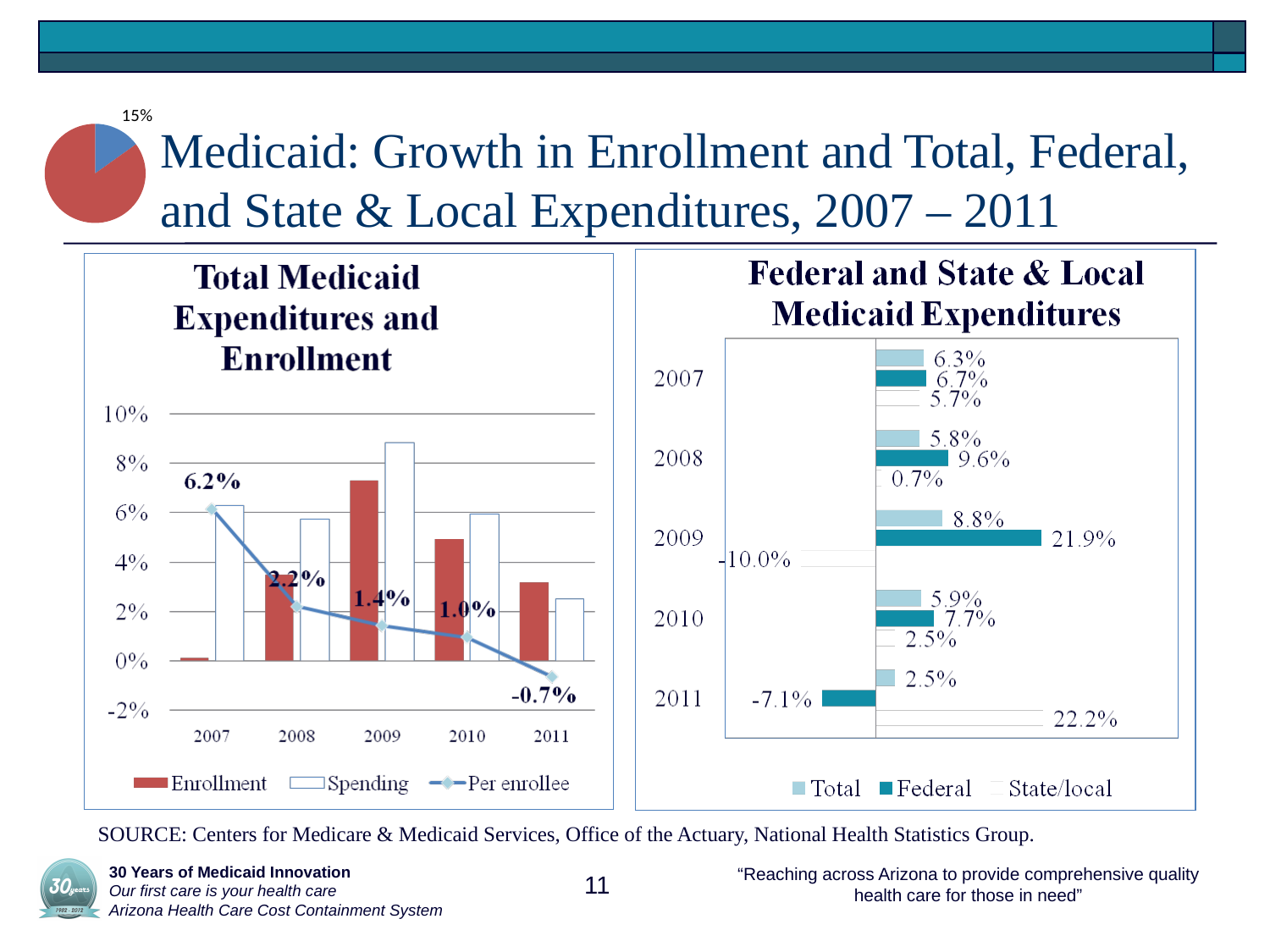
What kind of chart is the 'Federal and State & Local Medicaid Expenditures' chart? bar chart In the 'Total Medicaid Expenditures and Enrollment' chart, is the Enrollment value for 2009 greater or less than 6%? greater How many years are shown in the 'Federal and State & Local Medicaid Expenditures' chart? 5 In the 'Federal and State & Local Medicaid Expenditures' chart, which is larger for 2008: Federal or State/local? Federal In the 'Total Medicaid Expenditures and Enrollment' chart, does the per enrollee line rise or fall from 2007 to 2011? fall In the 'Federal and State & Local Medicaid Expenditures' chart, which year has the lowest Federal value? 2011 In the 'Total Medicaid Expenditures and Enrollment' chart, what is the per enrollee growth value for 2011? -0.7% In the 'Total Medicaid Expenditures and Enrollment' chart, what is the per enrollee growth value for 2007? 6.2% How many series does the legend of the 'Total Medicaid Expenditures and Enrollment' chart list? 3 In the 'Federal and State & Local Medicaid Expenditures' chart, what is the State/local value for 2011? 22.2% In the 'Federal and State & Local Medicaid Expenditures' chart, what is the Federal value for 2009? 21.9% In the 'Total Medicaid Expenditures and Enrollment' chart, what is the difference between the per enrollee values for 2007 and 2008? 4.0 percentage points